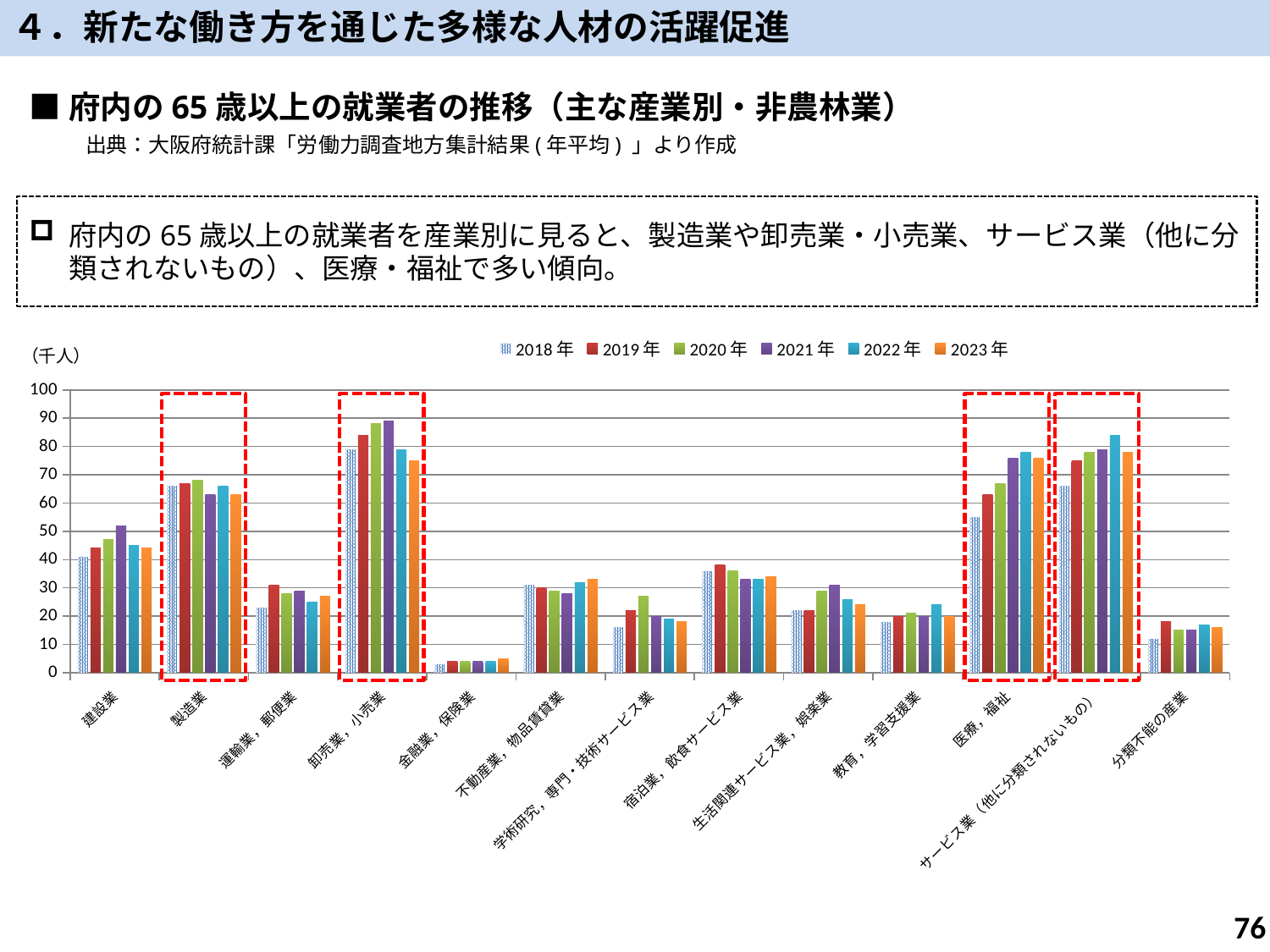
Which industry category has the lowest bars in the chart? 金融業，保険業 How many series does the legend list? 6 Which industry category has the highest bar in the chart? 卸売業，小売業 What unit is shown at the top left of the chart's vertical axis? 千人 Is the value for 宿泊業，飲食サービス業 in 2019年 greater or less than 30? greater What kind of chart is shown on the slide? bar chart How many industry categories are shown on the x axis? 13 Which is larger in 2021年: 卸売業，小売業 or 製造業? 卸売業，小売業 Is the value for 金融業，保険業 in 2023年 greater or less than 10? less Which is larger in 2018年: 医療，福祉 or サービス業（他に分類されないもの）? サービス業（他に分類されないもの） Is the value for 卸売業，小売業 in 2021年 greater or less than 80? greater